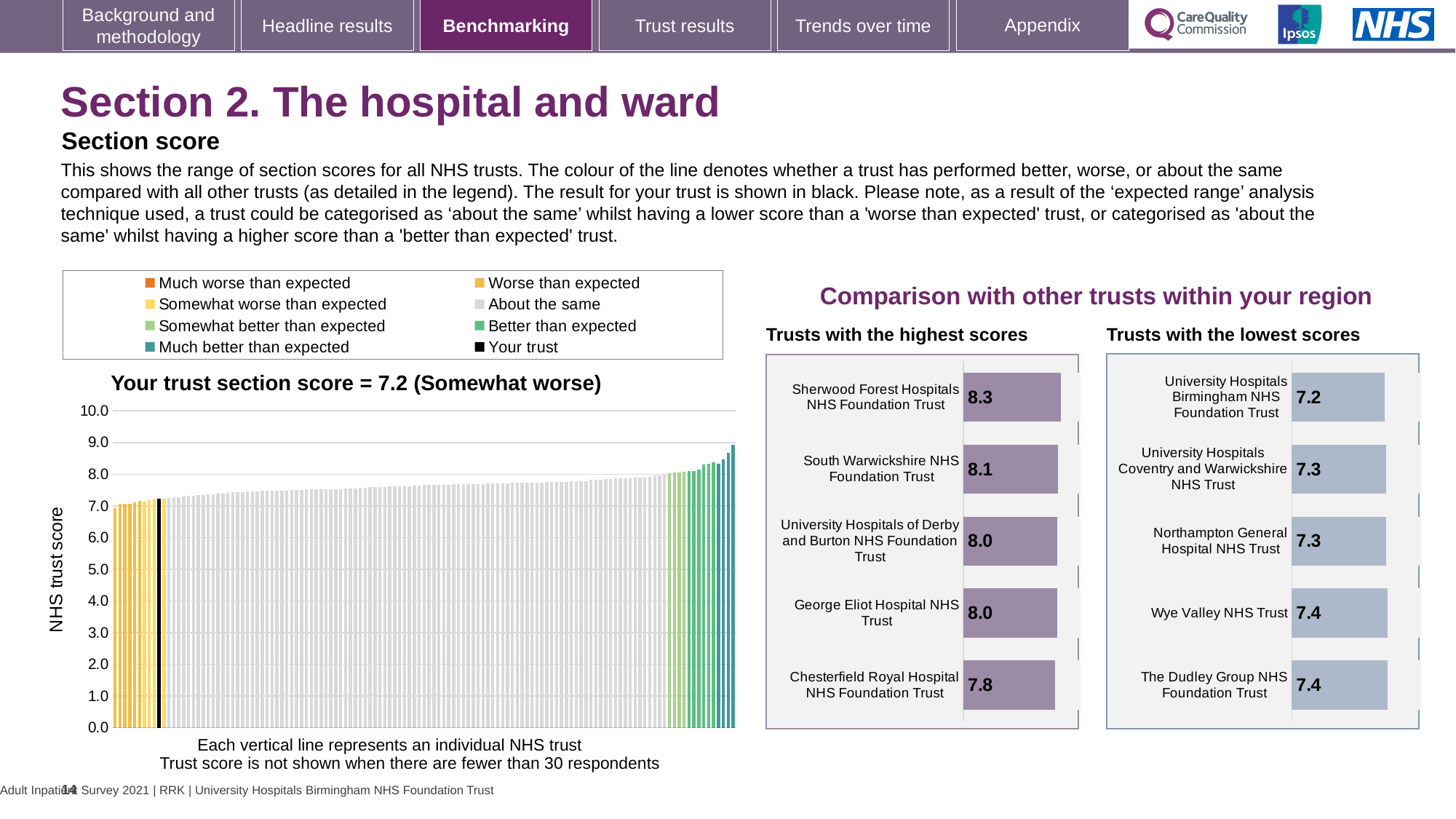
In the 'Trusts with the highest scores' chart, which trust has the highest score? Sherwood Forest Hospitals NHS Foundation Trust In the 'Trusts with the highest scores' chart, what is the score for Sherwood Forest Hospitals NHS Foundation Trust? 8.3 In the 'Trusts with the highest scores' chart, which has the higher score: South Warwickshire NHS Foundation Trust or George Eliot Hospital NHS Trust? South Warwickshire NHS Foundation Trust In the 'Trusts with the lowest scores' chart, what is the difference between the scores of Northampton General Hospital NHS Trust and University Hospitals Birmingham NHS Foundation Trust? 0.1 In the 'Trusts with the lowest scores' chart, which trust has the lowest score? University Hospitals Birmingham NHS Foundation Trust In the 'Trusts with the highest scores' chart, what is the score for Chesterfield Royal Hospital NHS Foundation Trust? 7.8 According to the title of the left-hand chart, what is your trust's section score? 7.2 (Somewhat worse) In the 'Trusts with the highest scores' chart, what is the difference between the scores of Sherwood Forest Hospitals NHS Foundation Trust and Chesterfield Royal Hospital NHS Foundation Trust? 0.5 How many trusts are listed in the 'Trusts with the highest scores' chart? 5 How many entries does the legend above the left-hand chart list? 8 What kind of chart is the left-hand chart showing the range of section scores for all NHS trusts? bar chart In the 'Trusts with the lowest scores' chart, what is the score for Wye Valley NHS Trust? 7.4